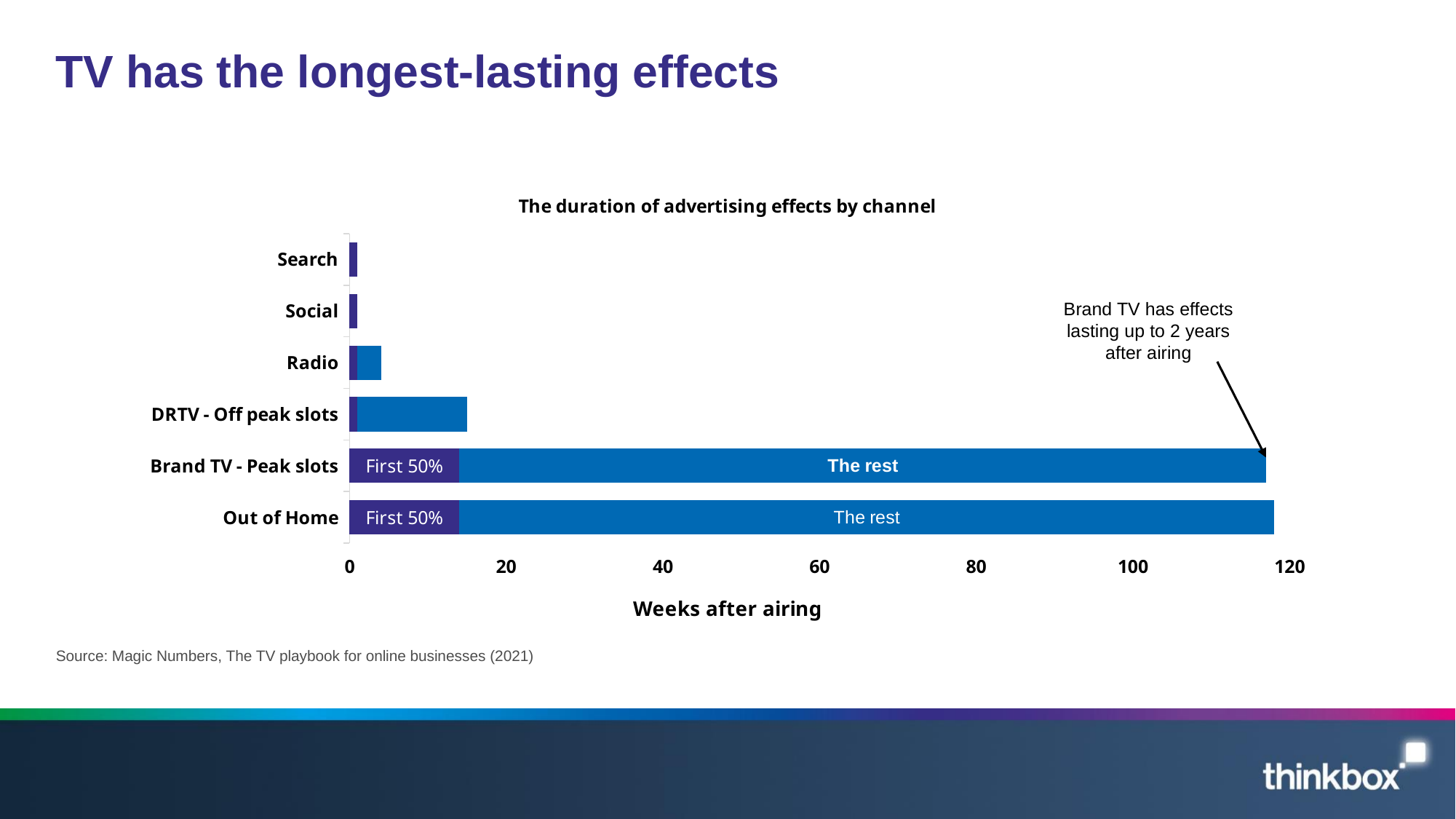
Is the value for Radio greater or less than 20 weeks? less What is the title of the chart? The duration of advertising effects by channel Is the value for DRTV - Off peak slots greater or less than 20 weeks? less What type of chart is shown on the slide? Bar chart What is the label of the horizontal axis? Weeks after airing Is the value for Search greater or less than 20 weeks? less Which has a longer duration of advertising effect, Brand TV - Peak slots or DRTV - Off peak slots? Brand TV - Peak slots How many channels (categories) are plotted in the chart? 6 Which has a longer duration of advertising effect, DRTV - Off peak slots or Radio? DRTV - Off peak slots Which has a longer duration of advertising effect, Radio or Social? Radio